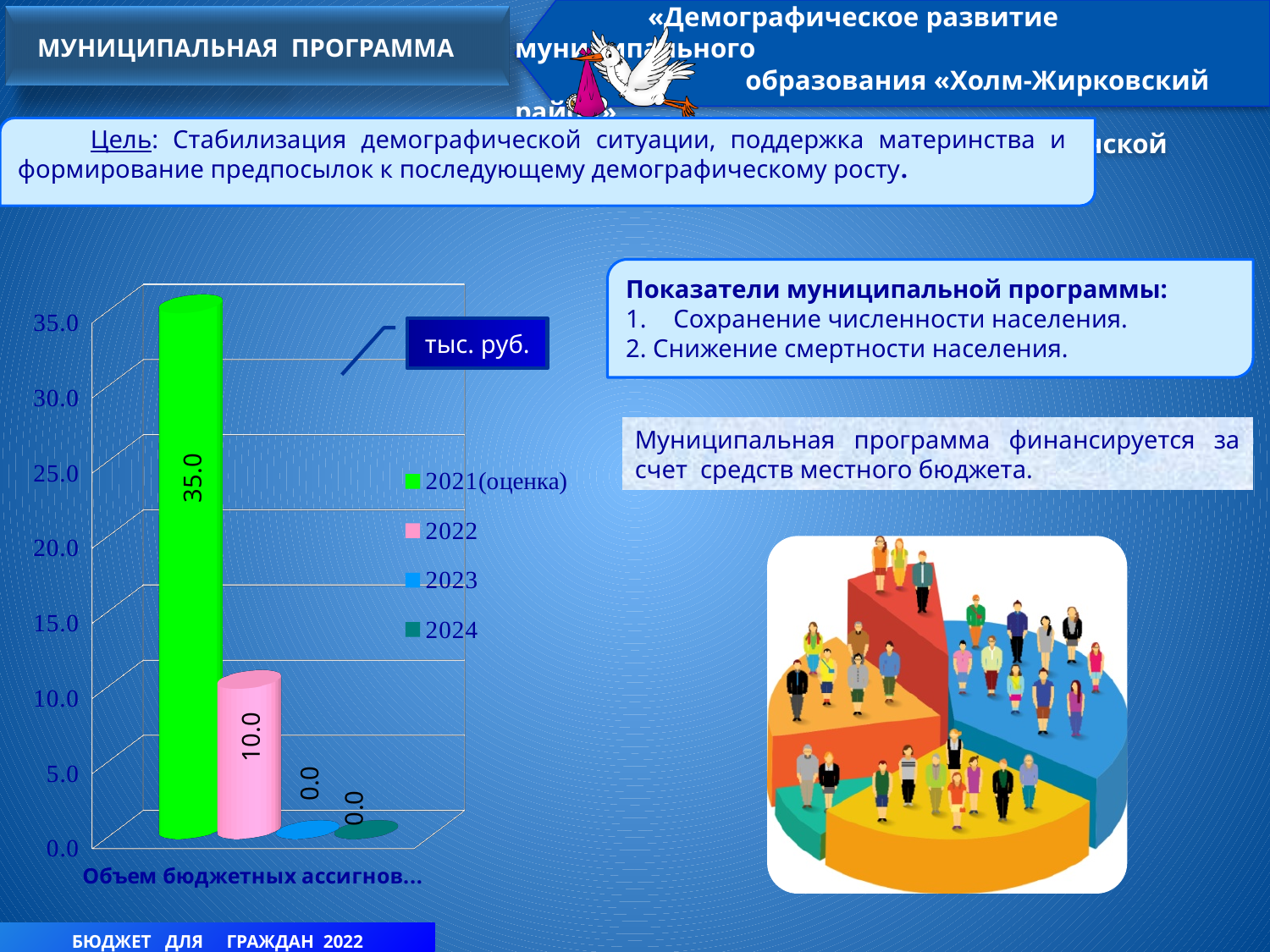
What kind of chart is shown on the slide? bar chart Which is larger, the value for 2021(оценка) or the value for 2022? 2021(оценка) What is the difference between the values for 2021(оценка) and 2022? 25.0 What is the value for 2023 in the chart? 0.0 Is the value for 2022 greater or less than 20.0? less What is the value for 2024 in the chart? 0.0 What is the value for 2022 in the chart? 10.0 Which year has the highest value in the chart? 2021(оценка) Do the values rise or fall from 2021(оценка) to 2024 in the chart? fall What is the value for 2021(оценка) in the chart? 35.0 How many series does the chart legend list? 4 What unit is shown in the label box next to the chart? тыс. руб.